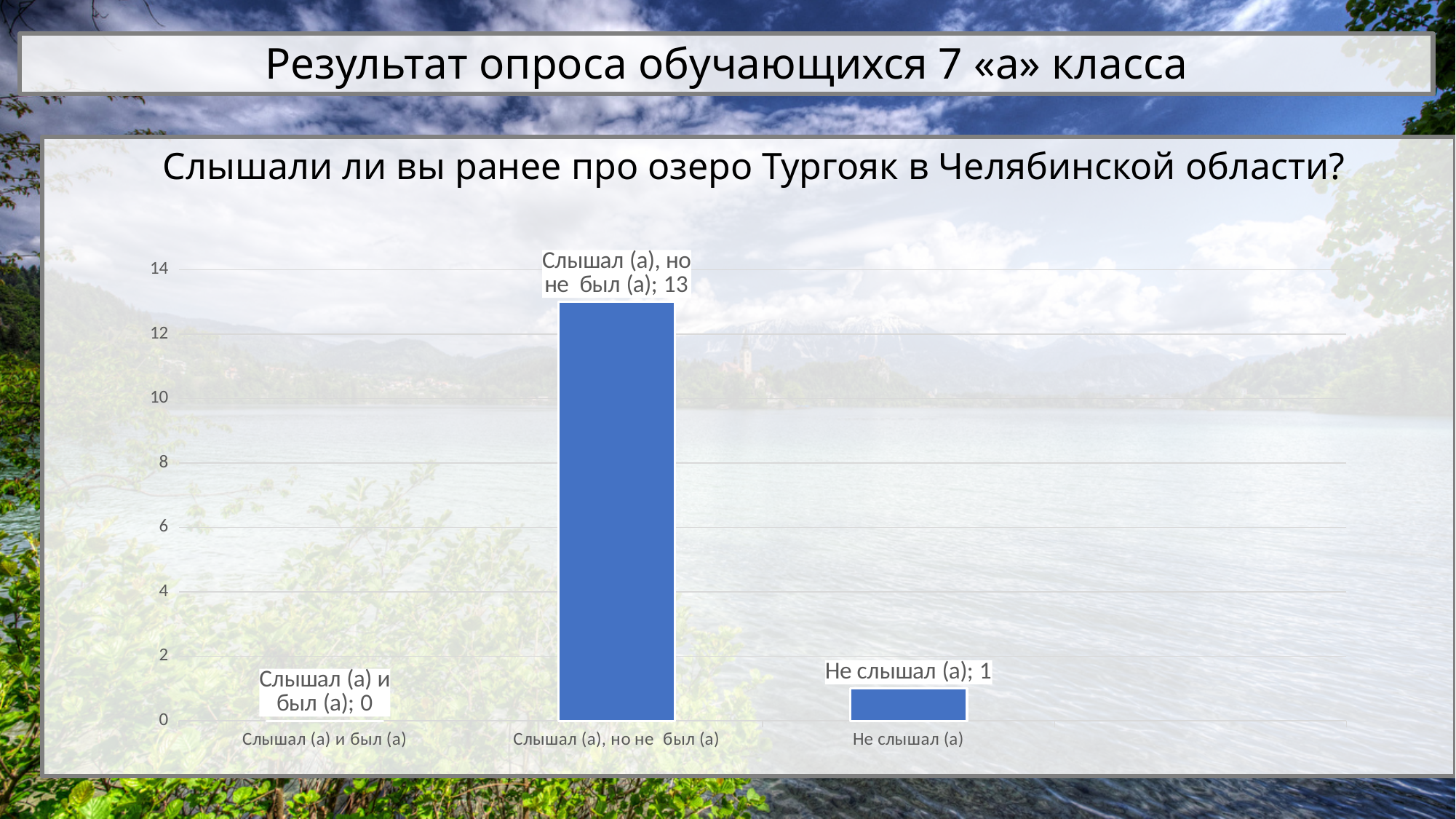
Which category has the lowest value? Слышал (а) и был (а) Is the value for "Слышал (а), но не был (а)" greater or less than 10? greater Which category has the highest value? Слышал (а), но не был (а) What is the difference between the values for "Слышал (а), но не был (а)" and "Не слышал (а)"? 12 What value is shown for "Слышал (а), но не был (а)"? 13 What value is shown for "Слышал (а) и был (а)"? 0 What value is shown for "Не слышал (а)"? 1 What is the title of the chart? Слышали ли вы ранее про озеро Тургояк в Челябинской области? Which is larger: the value for "Не слышал (а)" or the value for "Слышал (а) и был (а)"? Не слышал (а) What kind of chart is shown on the slide? bar chart What is the total of all three values shown in the chart? 14 How many categories are shown on the x axis? 3